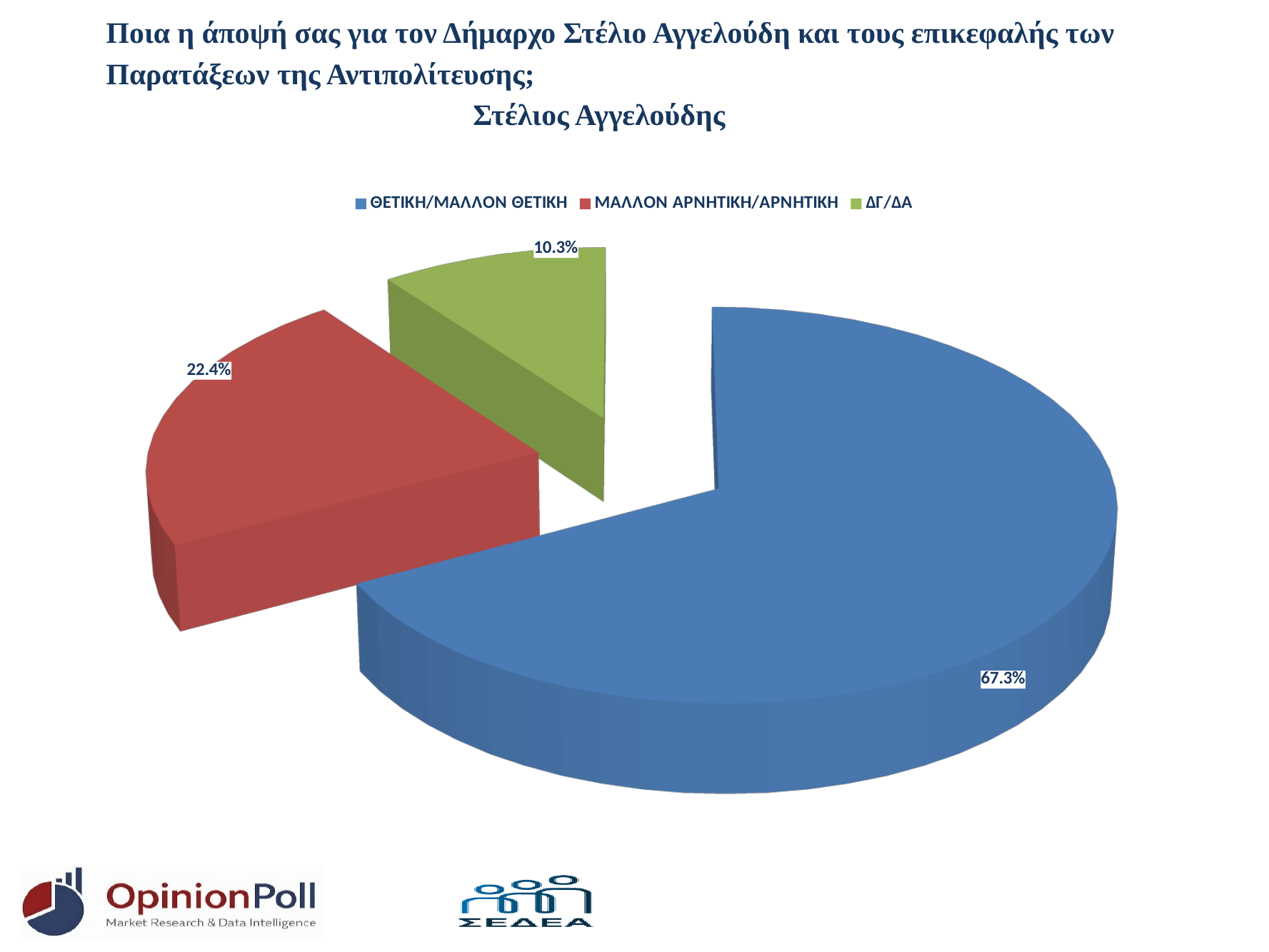
Which category has the smallest share of the pie? ΔΓ/ΔΑ What percentage of respondents gave a ΘΕΤΙΚΗ/ΜΑΛΛΟΝ ΘΕΤΙΚΗ opinion of Στέλιος Αγγελούδης? 67.3% What percentage of respondents gave a ΜΑΛΛΟΝ ΑΡΝΗΤΙΚΗ/ΑΡΝΗΤΙΚΗ opinion? 22.4% What is the difference in percentage points between ΜΑΛΛΟΝ ΑΡΝΗΤΙΚΗ/ΑΡΝΗΤΙΚΗ and ΔΓ/ΔΑ? 12.1 What colour is the ΔΓ/ΔΑ slice? Green What is the value of the ΔΓ/ΔΑ slice? 10.3% Which is larger, the ΜΑΛΛΟΝ ΑΡΝΗΤΙΚΗ/ΑΡΝΗΤΙΚΗ slice or the ΔΓ/ΔΑ slice? ΜΑΛΛΟΝ ΑΡΝΗΤΙΚΗ/ΑΡΝΗΤΙΚΗ What kind of chart is shown on the slide? Pie chart What is the difference in percentage points between ΘΕΤΙΚΗ/ΜΑΛΛΟΝ ΘΕΤΙΚΗ and ΜΑΛΛΟΝ ΑΡΝΗΤΙΚΗ/ΑΡΝΗΤΙΚΗ? 44.9 How many slices does the pie chart have? 3 Which person is the pie chart about, according to the subtitle? Στέλιος Αγγελούδης Which category has the largest share of the pie? ΘΕΤΙΚΗ/ΜΑΛΛΟΝ ΘΕΤΙΚΗ